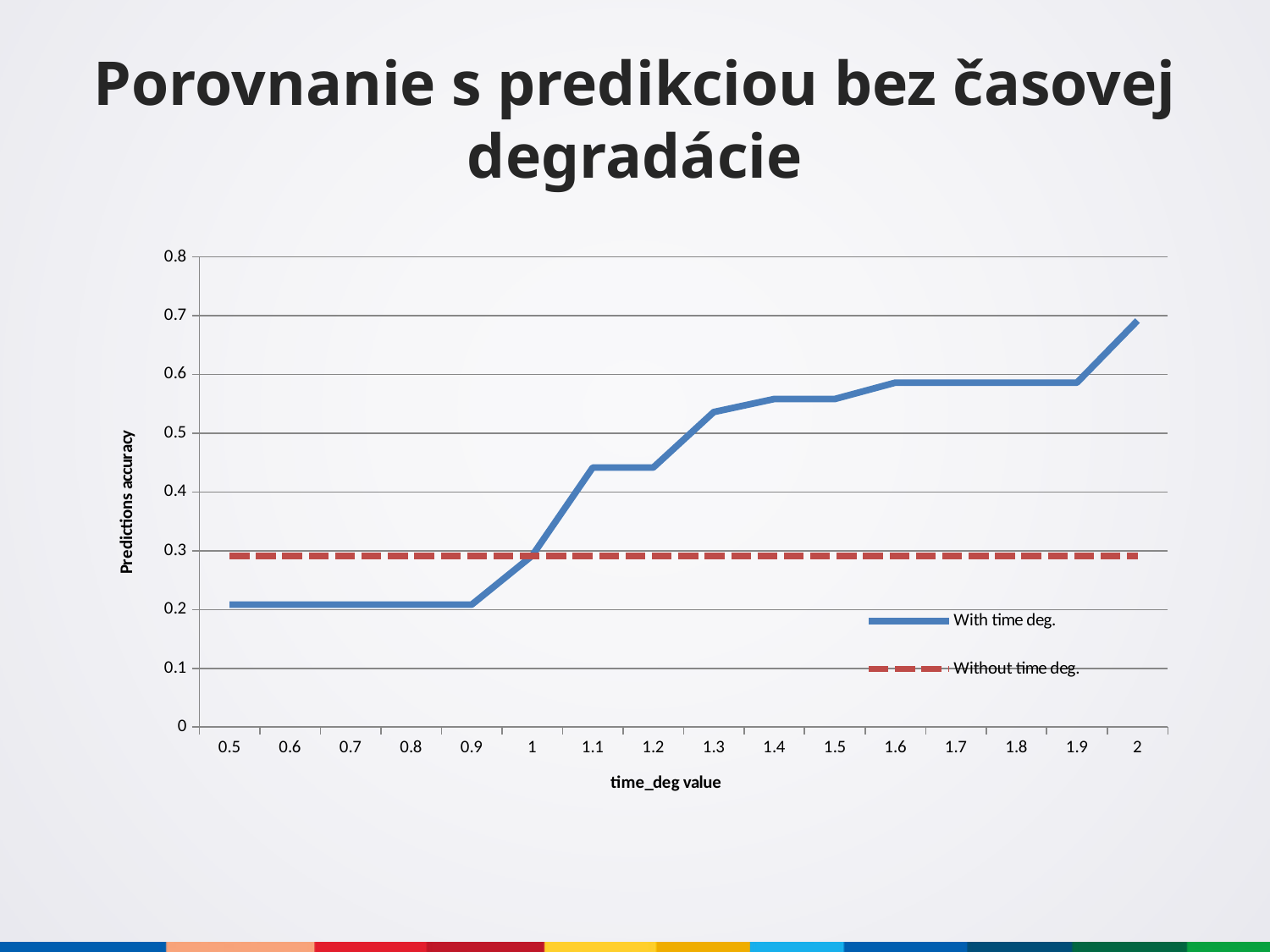
What is the title of the y axis? Predictions accuracy At time_deg value 0.5, which series has the higher prediction accuracy, 'With time deg.' or 'Without time deg.'? Without time deg. What kind of chart is shown on the slide? line chart At which time_deg value does the 'With time deg.' series reach its highest value? 2 Is the value of 'With time deg.' at time_deg value 1.3 greater or less than 0.5? greater Is the value of 'Without time deg.' greater or less than 0.4? less Is the value of 'With time deg.' at time_deg value 2 greater or less than 0.6? greater How many time_deg values are plotted along the x axis? 16 Does the 'With time deg.' series generally rise or fall as the time_deg value increases? rise How many series does the legend list? 2 At time_deg value 2, which series has the higher prediction accuracy, 'With time deg.' or 'Without time deg.'? With time deg.